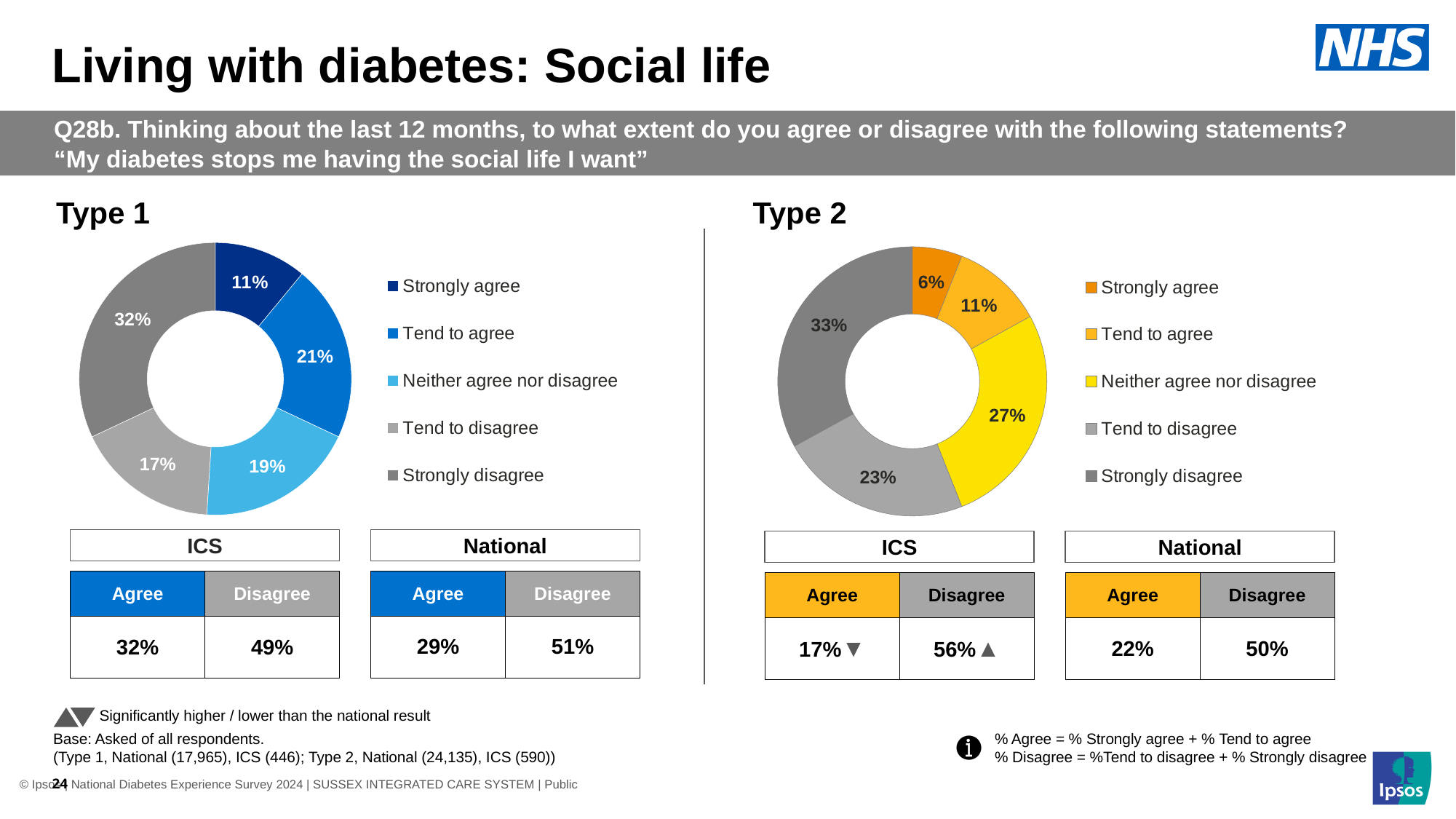
In the Type 1 chart, what percentage is shown for Neither agree nor disagree? 19% In the Type 2 chart, which category has the smallest share? Strongly agree In the Type 1 chart, which category has the largest share? Strongly disagree In the Type 2 chart, what percentage is shown for Tend to disagree? 23% What kind of chart is used for Type 2? Donut (pie) chart In the Type 1 chart, what percentage is shown for Strongly agree? 11% In the Type 1 chart, what colour represents Strongly agree? Dark blue In the Type 1 chart, what is the difference between the Strongly disagree and Tend to disagree percentages? 15% In the Type 2 chart, which is larger: Tend to disagree or Neither agree nor disagree? Neither agree nor disagree In the Type 2 chart, what percentage is shown for Strongly agree? 6% In the Type 2 chart, what is the difference between the Neither agree nor disagree and Tend to agree percentages? 16% How many categories does the Type 1 chart's legend list? 5